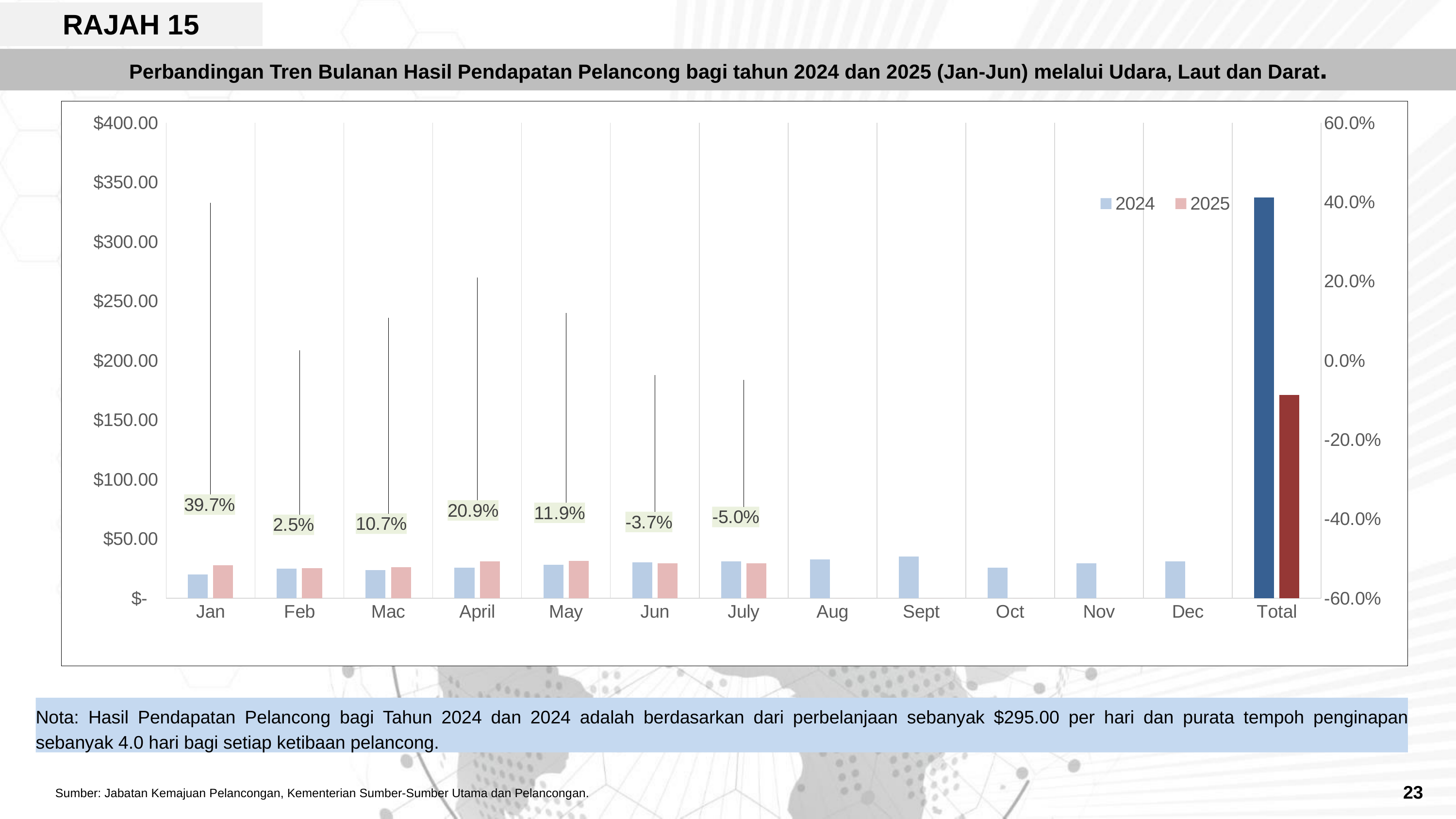
What percentage label is shown for Jun? -3.7% What is the difference between the percentage labels for Jan and Feb? 37.2 percentage points Which has the larger percentage label, Mac or May? May What percentage label is shown for Jan? 39.7% Is the 2025 bar for Total greater or less than $200.00? less What kind of chart is shown on the slide? Bar chart Which month has the highest percentage label? Jan Which month has the lowest percentage label? July What percentage label is shown for April? 20.9% Is the 2024 bar for Total greater or less than $300.00? greater How many categories are shown on the x axis? 13 How many series does the legend list? 2